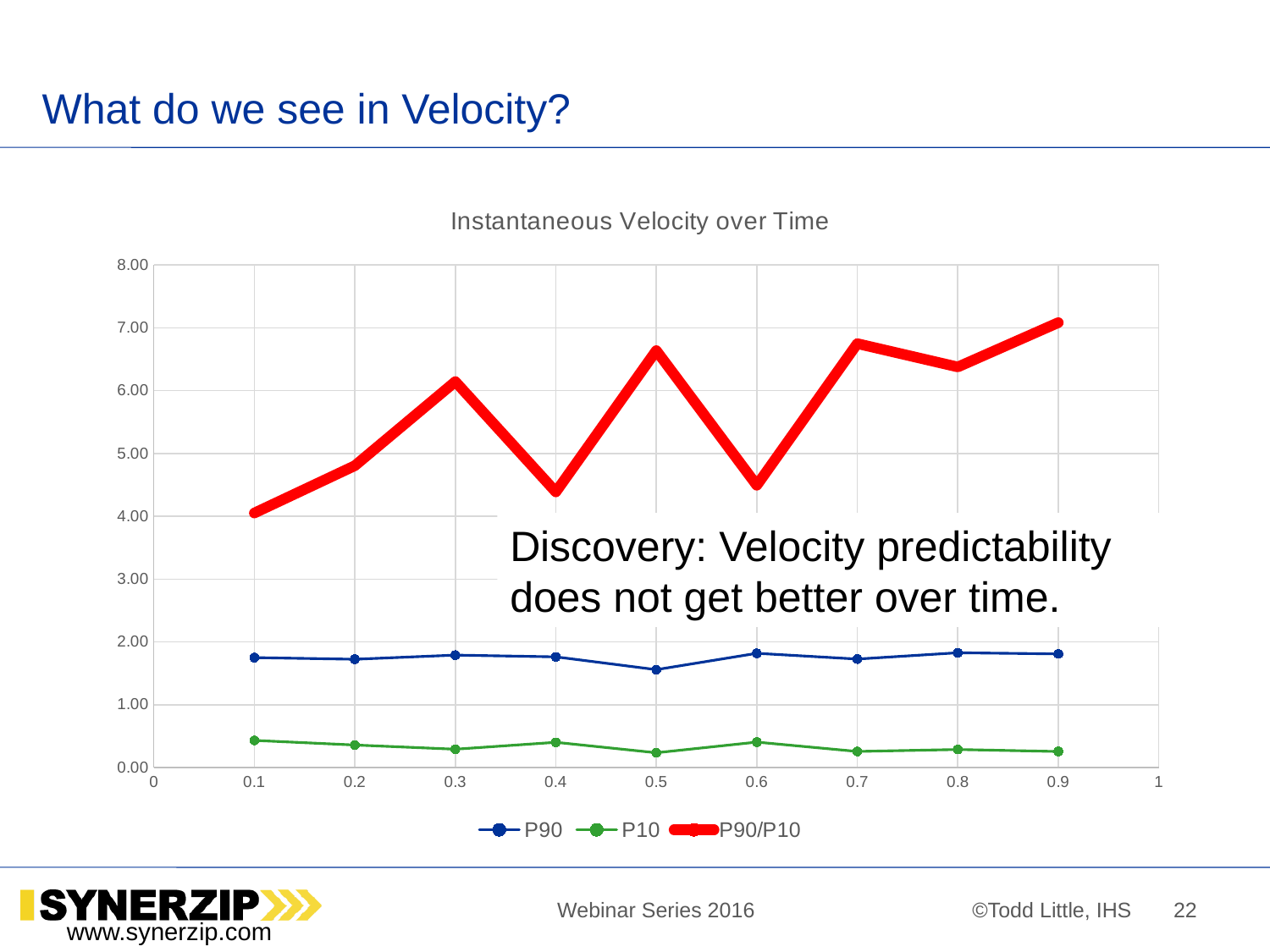
Is the value of P90/P10 at x = 0.5 greater or less than 6.00? greater Is the value of P90 at x = 0.3 greater or less than 2.00? less Is the value of P90/P10 at x = 0.1 greater or less than 5.00? less What kind of chart is shown on the slide? Line chart At which x value is the P90/P10 series highest? 0.9 At which x value is the P90/P10 series lowest? 0.1 How many data points are plotted for the P90/P10 series? 9 What is the title of the chart? Instantaneous Velocity over Time At which x value is the P90 series lowest? 0.5 Which is larger, the P90/P10 value at x = 0.4 or at x = 0.5? 0.5 Which series is drawn with the thick red line? P90/P10 How many series does the legend list? 3